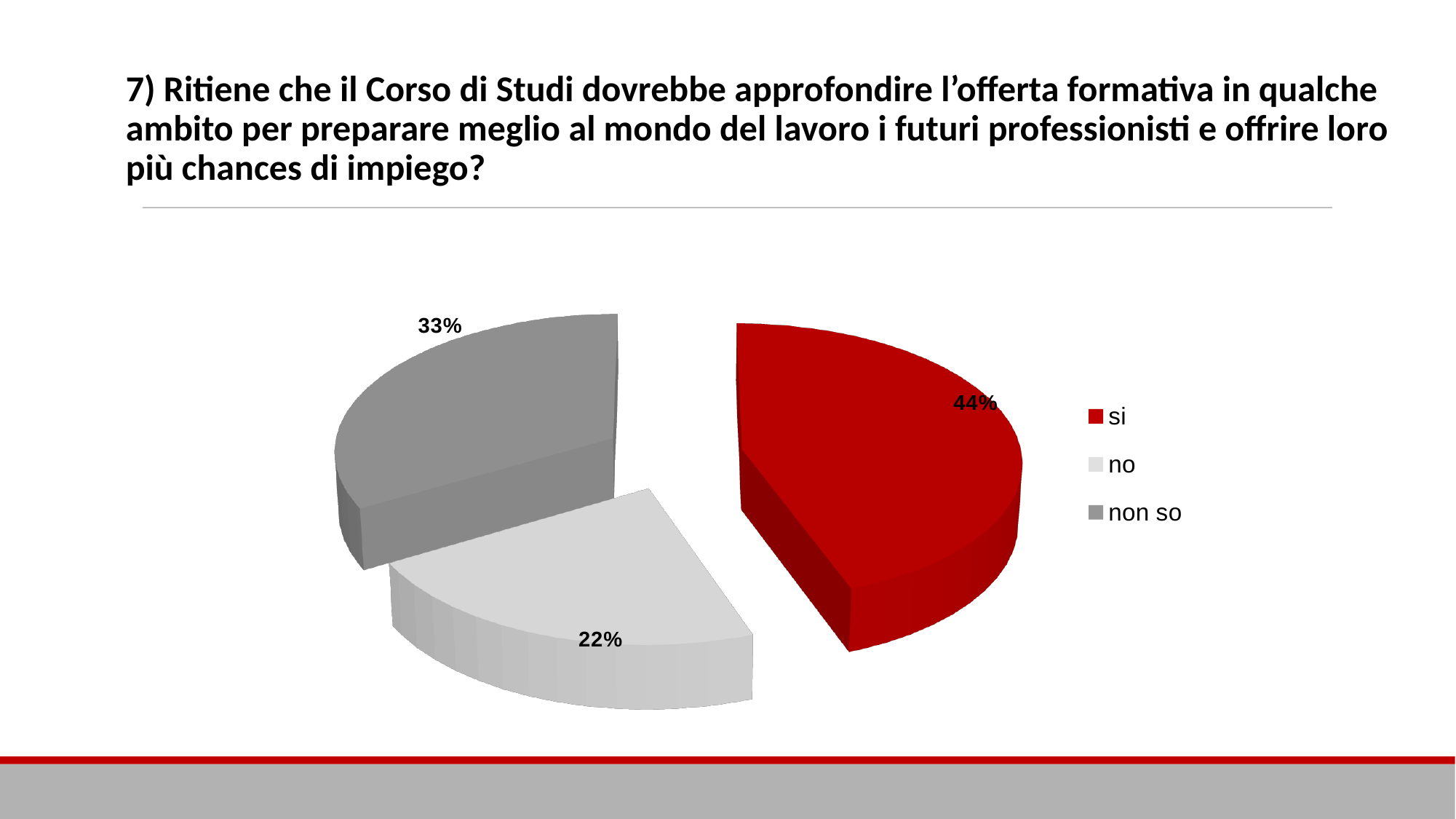
Which response has the largest share of the pie? si Which response has the smallest share of the pie? no What is the difference in percentage points between the "si" and "no" slices? 22 Which is larger, the "non so" slice or the "no" slice? non so What colour is the "si" slice? red What kind of chart is shown on the slide? pie chart What is the difference in percentage points between the "non so" and "no" slices? 11 What percentage of respondents answered "si"? 44% What percentage of respondents answered "non so"? 33% How many slices does the pie chart have? 3 What percentage of respondents answered "no"? 22% How many entries does the legend list? 3